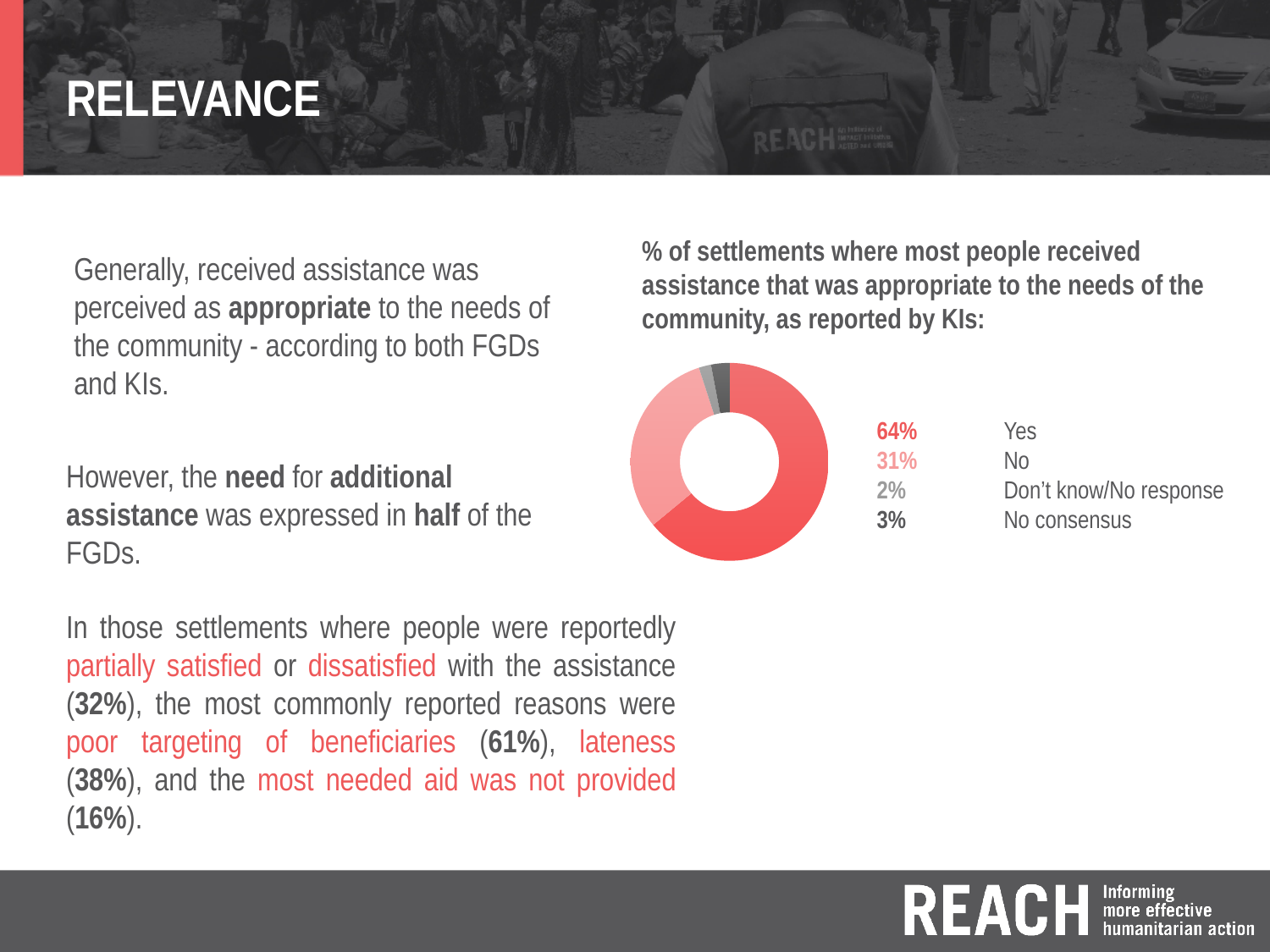
What type of chart is shown on the slide? Donut (pie) chart What percentage of settlements reported 'Yes' in the chart of settlements where most people received assistance appropriate to the needs of the community? 64% What percentage of settlements reported 'No' in the donut chart? 31% What is the difference in percentage points between the 'Yes' and 'No' shares in the donut chart? 33 Which category has the largest share in the donut chart? Yes According to the chart title, who reported the data shown in the donut chart? KIs What is the combined share of 'Yes' and 'No' in the donut chart? 95% What share of the donut chart is 'No consensus'? 3% What share of the donut chart is 'Don't know/No response'? 2% Which is larger in the donut chart, the 'No consensus' share or the 'Don't know/No response' share? No consensus How many categories are shown in the donut chart's legend? 4 Which category has the smallest share in the donut chart? Don't know/No response